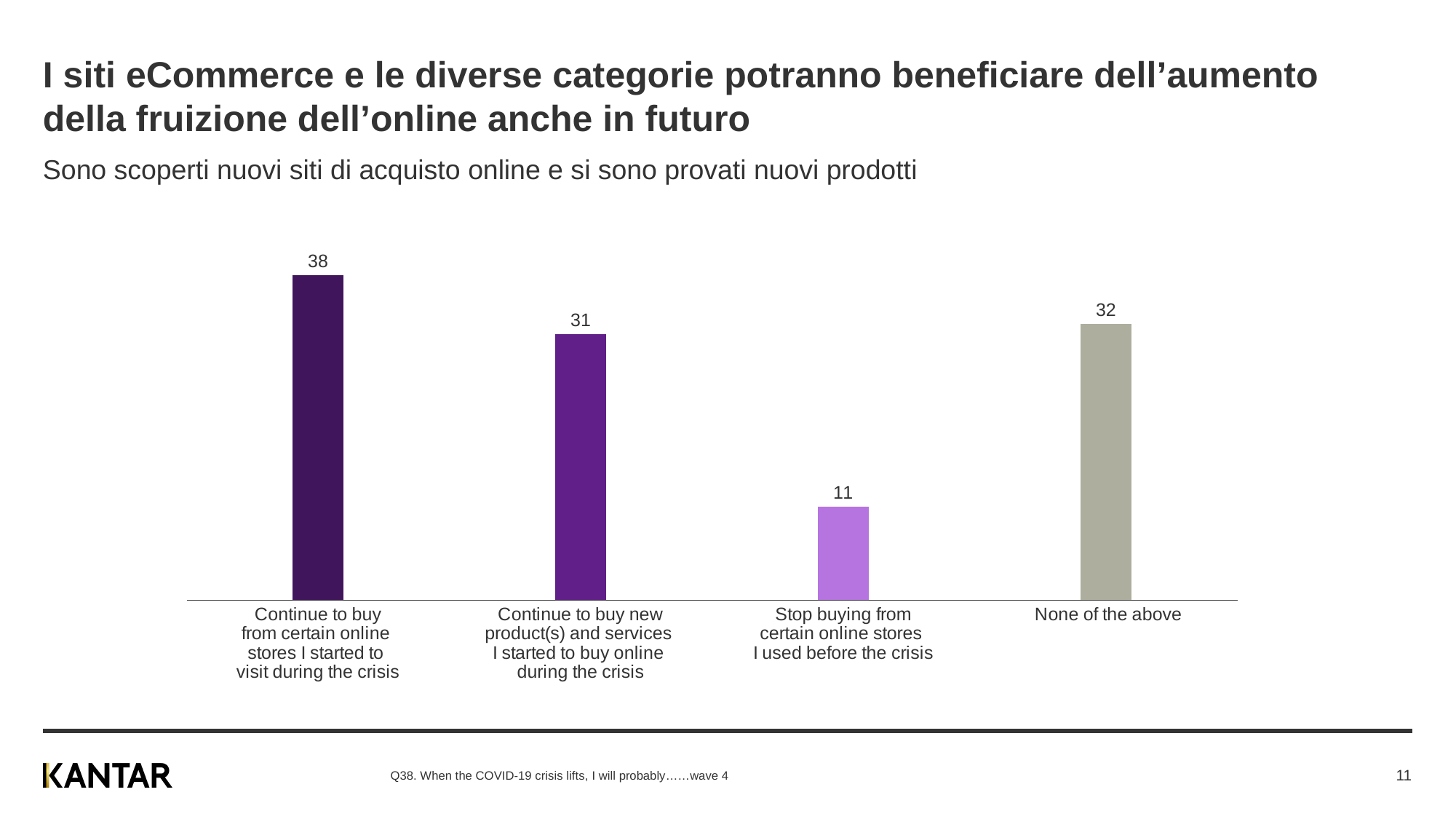
How many categories are shown in the chart? 4 What kind of chart is shown on the slide? Bar chart What is the value for "Continue to buy new product(s) and services I started to buy online during the crisis"? 31 What is the value for "None of the above"? 32 What is the difference between the values for "None of the above" and "Continue to buy new product(s) and services I started to buy online during the crisis"? 1 What colour is the bar for "None of the above"? Grey What is the value for "Continue to buy from certain online stores I started to visit during the crisis"? 38 What is the difference between the values for "Continue to buy from certain online stores I started to visit during the crisis" and "Stop buying from certain online stores I used before the crisis"? 27 Which category has the lowest value? Stop buying from certain online stores I used before the crisis Which is larger: the value for "Continue to buy from certain online stores I started to visit during the crisis" or the value for "None of the above"? Continue to buy from certain online stores I started to visit during the crisis What is the value for "Stop buying from certain online stores I used before the crisis"? 11 Which category has the highest value? Continue to buy from certain online stores I started to visit during the crisis